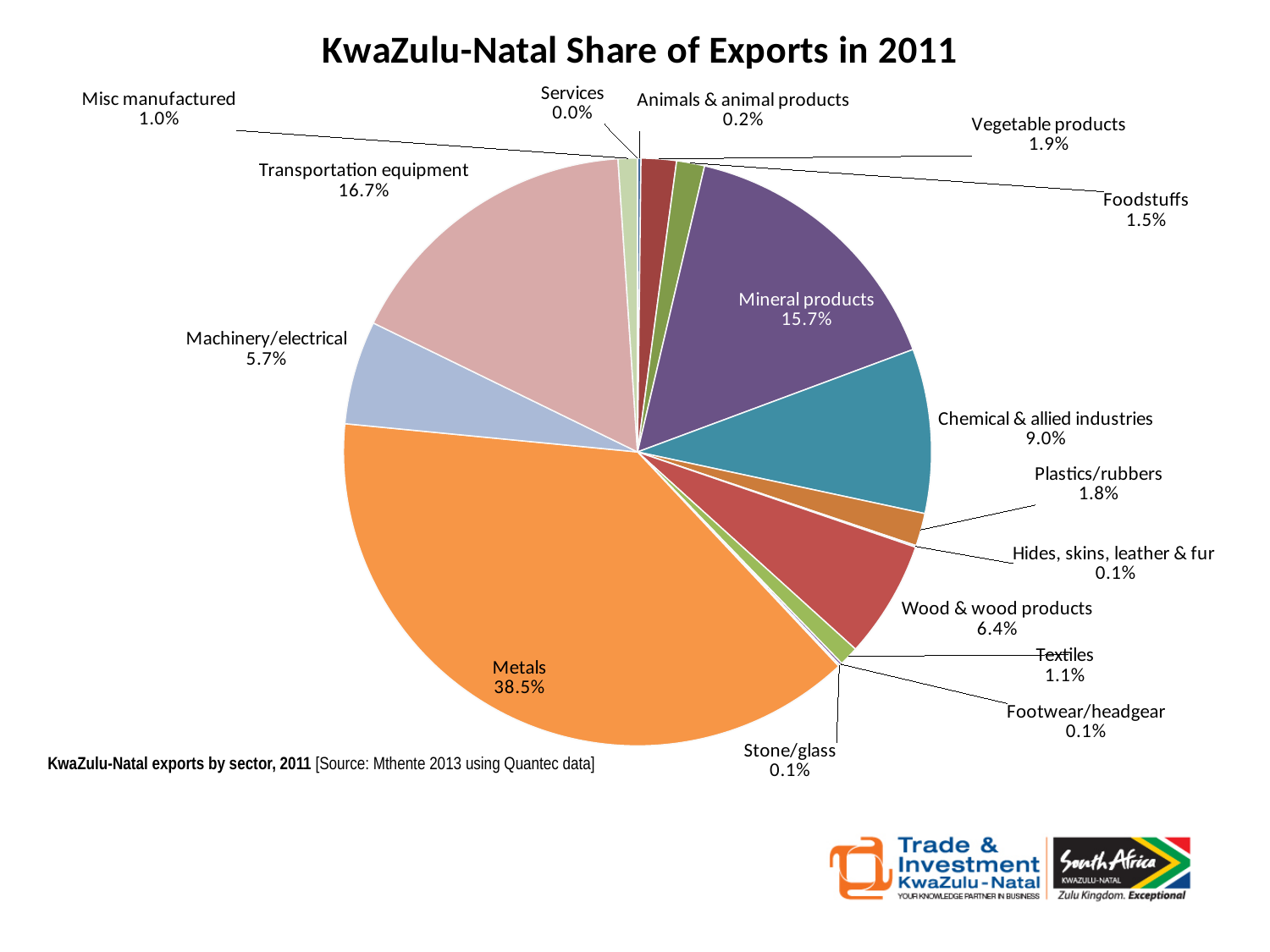
How many sectors are shown in the pie chart? 16 What is the difference between the shares of Machinery/electrical and Vegetable products? 3.8% Which has a larger share, Mineral products or Chemical & allied industries? Mineral products Which sector has the smallest share of exports? Services Which sector has the largest share of exports? Metals What is the share for Wood & wood products? 6.4% What kind of chart is shown on the slide? pie chart What is the difference between the shares of Metals and Transportation equipment? 21.8% What is the share for Chemical & allied industries? 9.0% What share of exports does Metals account for? 38.5% What is the title of the chart? KwaZulu-Natal Share of Exports in 2011 What is the share for Transportation equipment? 16.7%